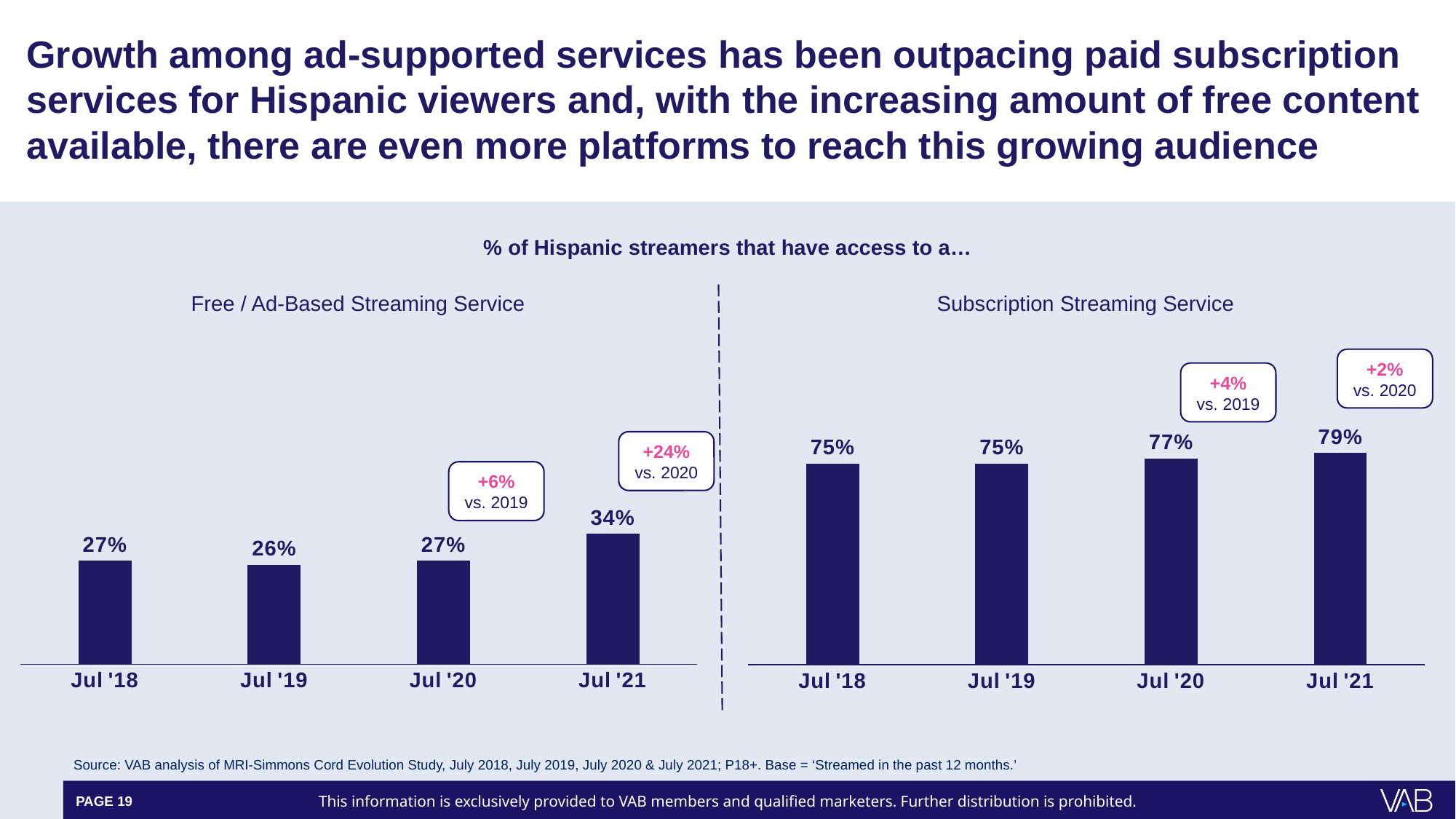
What kind of chart is the Free / Ad-Based Streaming Service chart? Bar chart What is the overall title shown above the two charts? % of Hispanic streamers that have access to a… In the Free / Ad-Based Streaming Service chart, what is the value for Jul '19? 26% In the Free / Ad-Based Streaming Service chart, what is the value for Jul '21? 34% How many periods are shown on the x axis of the Subscription Streaming Service chart? 4 In the Subscription Streaming Service chart, what is the difference between the Jul '21 and Jul '18 values? 4 percentage points In the Subscription Streaming Service chart, which period has the highest value? Jul '21 In the Subscription Streaming Service chart, do the values generally rise or fall from Jul '18 to Jul '21? Rise In the Free / Ad-Based Streaming Service chart, what is the difference between the Jul '21 and Jul '20 values? 7 percentage points In the Subscription Streaming Service chart, what is the value for Jul '20? 77% In the Free / Ad-Based Streaming Service chart, which is larger: the value for Jul '18 or Jul '21? Jul '21 In the Free / Ad-Based Streaming Service chart, which period has the lowest value? Jul '19